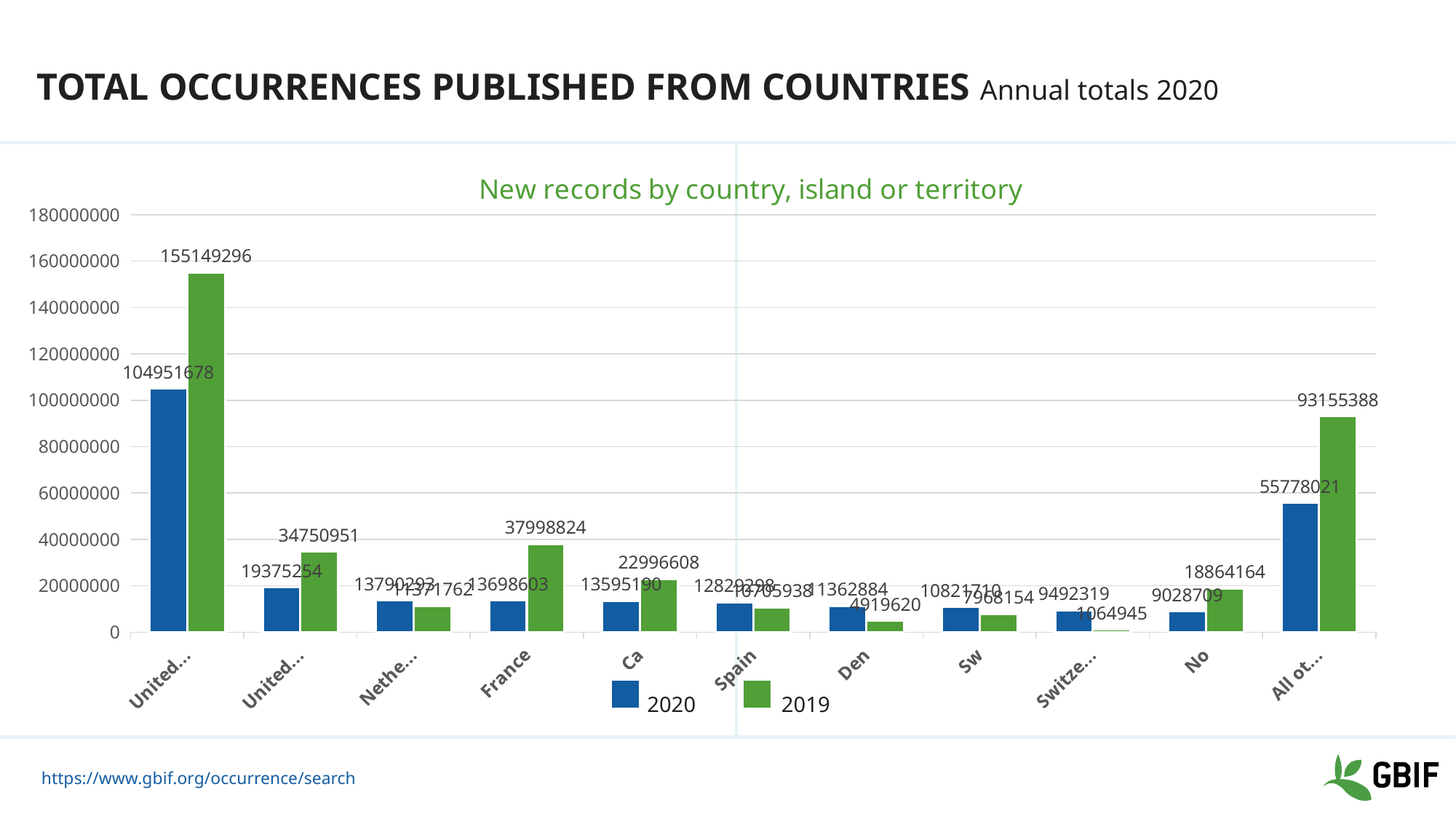
What is the 2019 value for No? 18864164 What is the 2020 value for France? 13698603 How many series does the legend list? 2 What is the difference between the 2019 and 2020 values for France? 24300221 What kind of chart is shown on the slide? bar chart What is the 2019 value for Ca? 22996608 What is the 2019 value for Den? 4919620 What is the title of the chart? New records by country, island or territory For Den, which series has the larger value, 2020 or 2019? 2020 What is the 2019 value for France? 37998824 How many categories are plotted along the x axis? 11 Which has the larger 2019 value, France or Ca? France